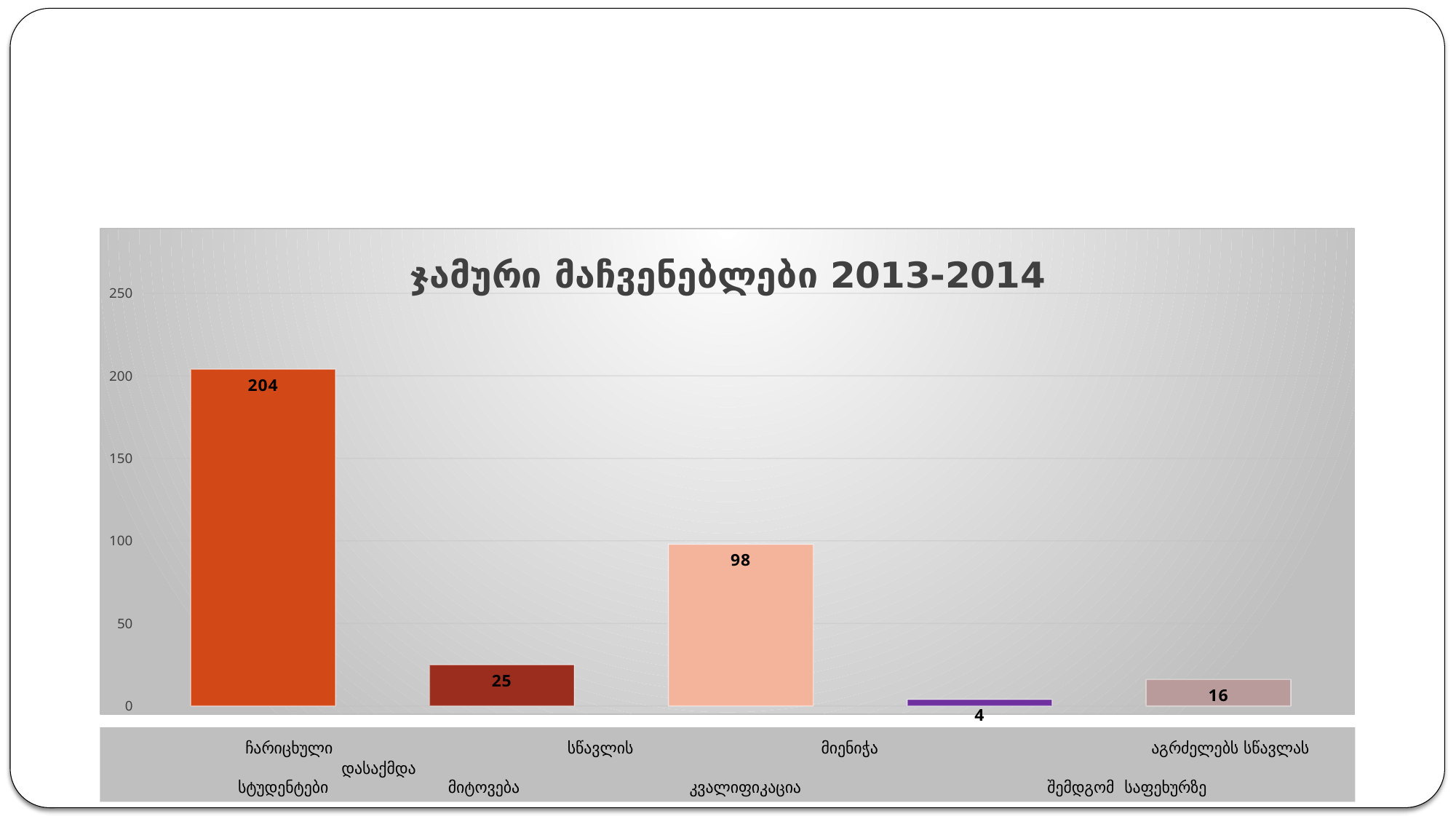
What is the value of the first (leftmost) bar, labelled ჩარიცხული სტუდენტები? 204 What is the title of the chart? ჯამური მაჩვენებლები 2013-2014 What is the value of the third bar from the left (the light pink bar)? 98 What is the value of the rightmost bar, labelled აგრძელებს სწავლას შემდგომ საფეხურზე? 16 What is the value of the second bar from the left (the dark red bar)? 25 What is the value of the fourth bar from the left (the purple bar)? 4 Which is larger: the second bar (25) or the rightmost bar (16)? the second bar (25) What is the lowest value shown in the chart? 4 How many bars are plotted in the chart? 5 What type of chart is shown on the slide? bar chart What is the difference between the first bar (204) and the third bar (98)? 106 Which bar has the highest value? ჩარიცხული სტუდენტები (204)